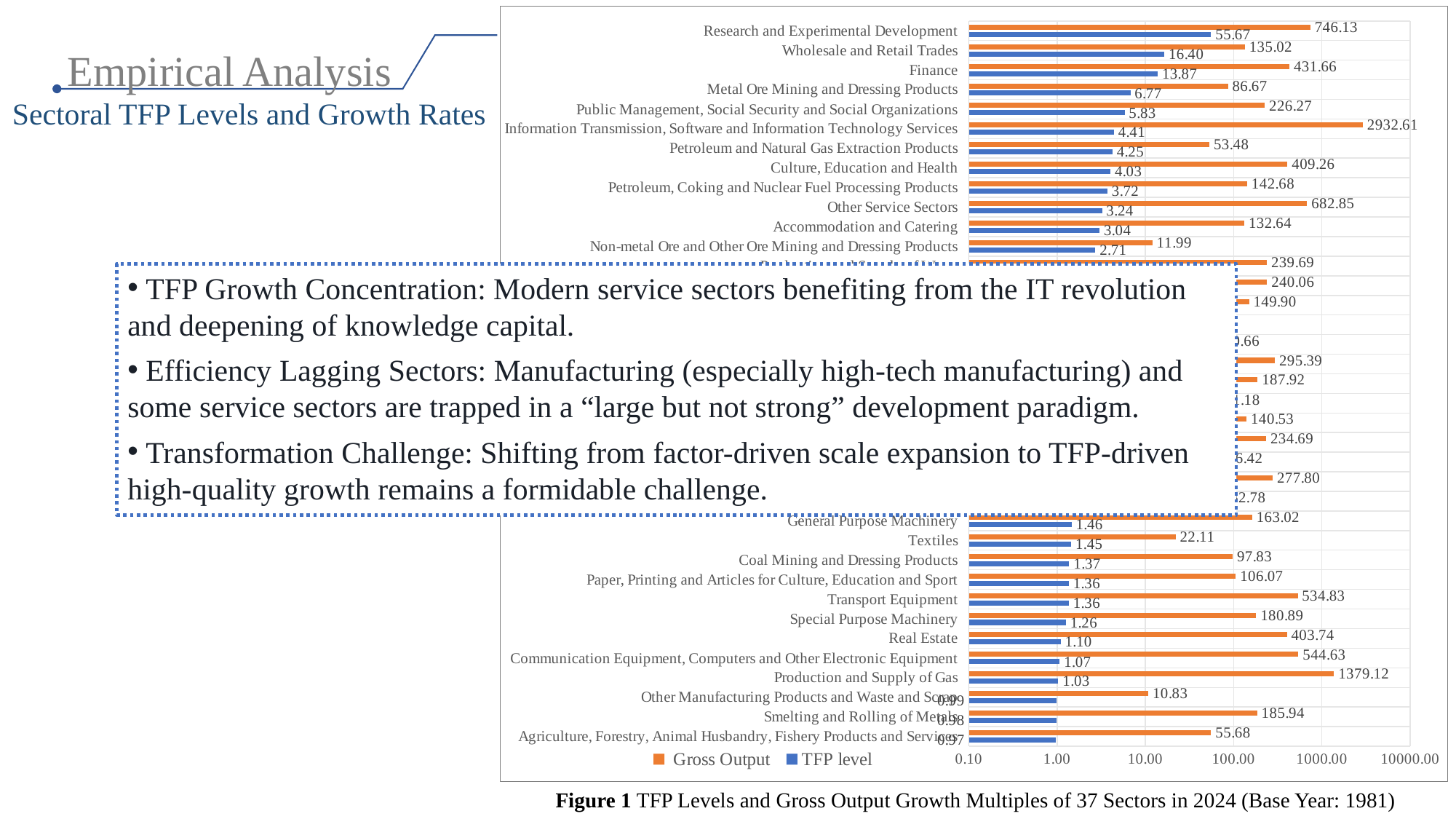
What is the difference between the Gross Output values for Research and Experimental Development and Wholesale and Retail Trades? 611.11 What is the Gross Output value for Production and Supply of Gas? 1379.12 What is the Gross Output value for Information Transmission, Software and Information Technology Services? 2932.61 What is the Gross Output value for Research and Experimental Development? 746.13 Is the TFP level for Real Estate greater or less than 10.00? less What is the TFP level for Finance? 13.87 Which has a larger Gross Output value, Textiles or Transport Equipment? Transport Equipment Which sector has the highest Gross Output value? Information Transmission, Software and Information Technology Services Which sector has the highest TFP level? Research and Experimental Development How many series does the legend list? 2 What is the TFP level for Wholesale and Retail Trades? 16.40 What kind of chart is shown on the slide? Bar chart